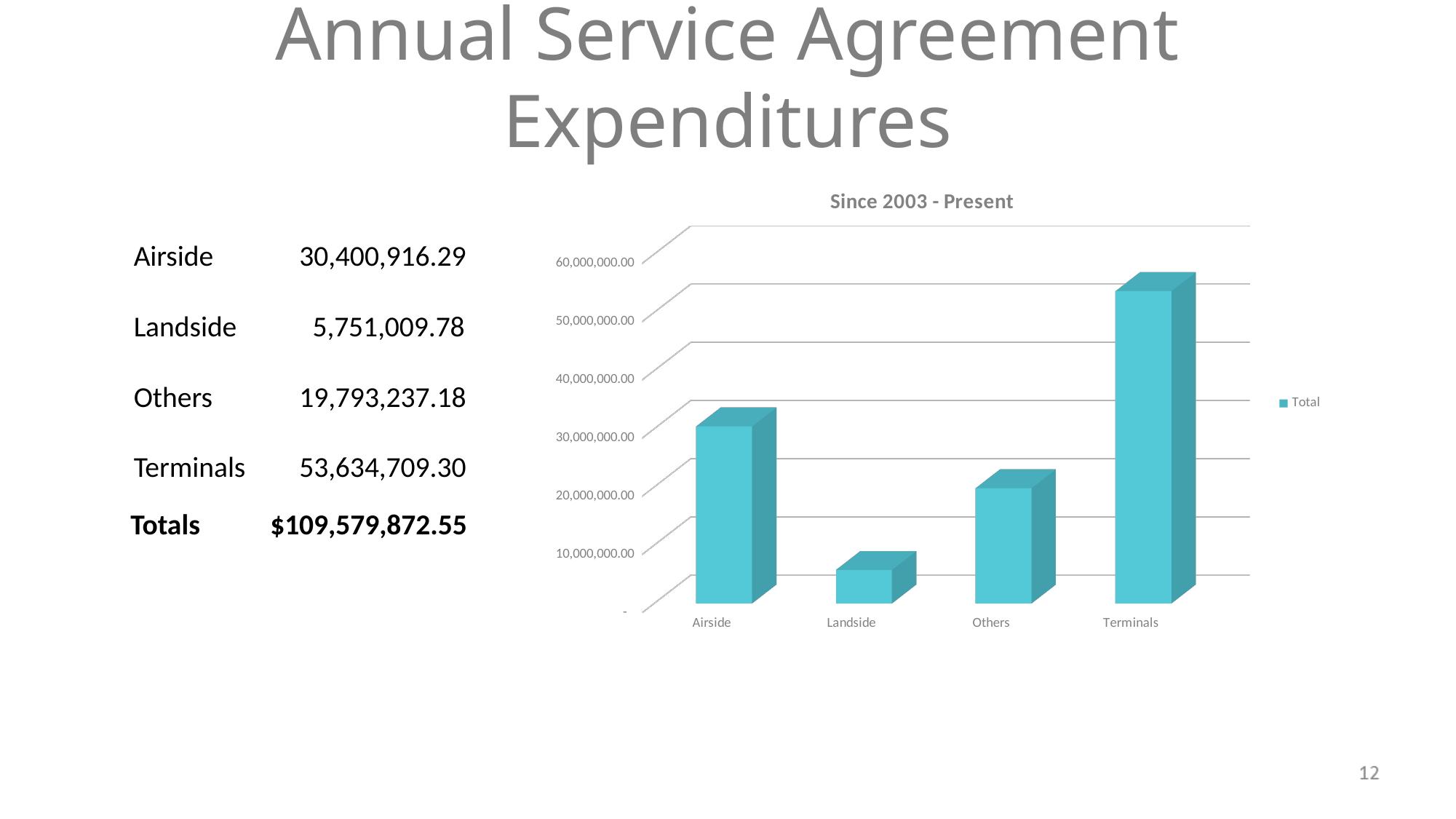
Which category has the highest value on the chart? Terminals Which category has the lowest value on the chart? Landside Is the value for Terminals greater or less than 50,000,000.00? greater Is the value for Others greater or less than 20,000,000.00? less How many categories are plotted on the chart? 4 What is the value for Airside? 30,400,916.29 Which is larger, the value for Airside or the value for Others? Airside What type of chart is shown on the slide? bar chart What is the difference between the values for Terminals and Landside? 47,883,699.52 What is the value for Terminals? 53,634,709.30 What is the title of the chart? Since 2003 - Present How many series does the chart legend list? 1